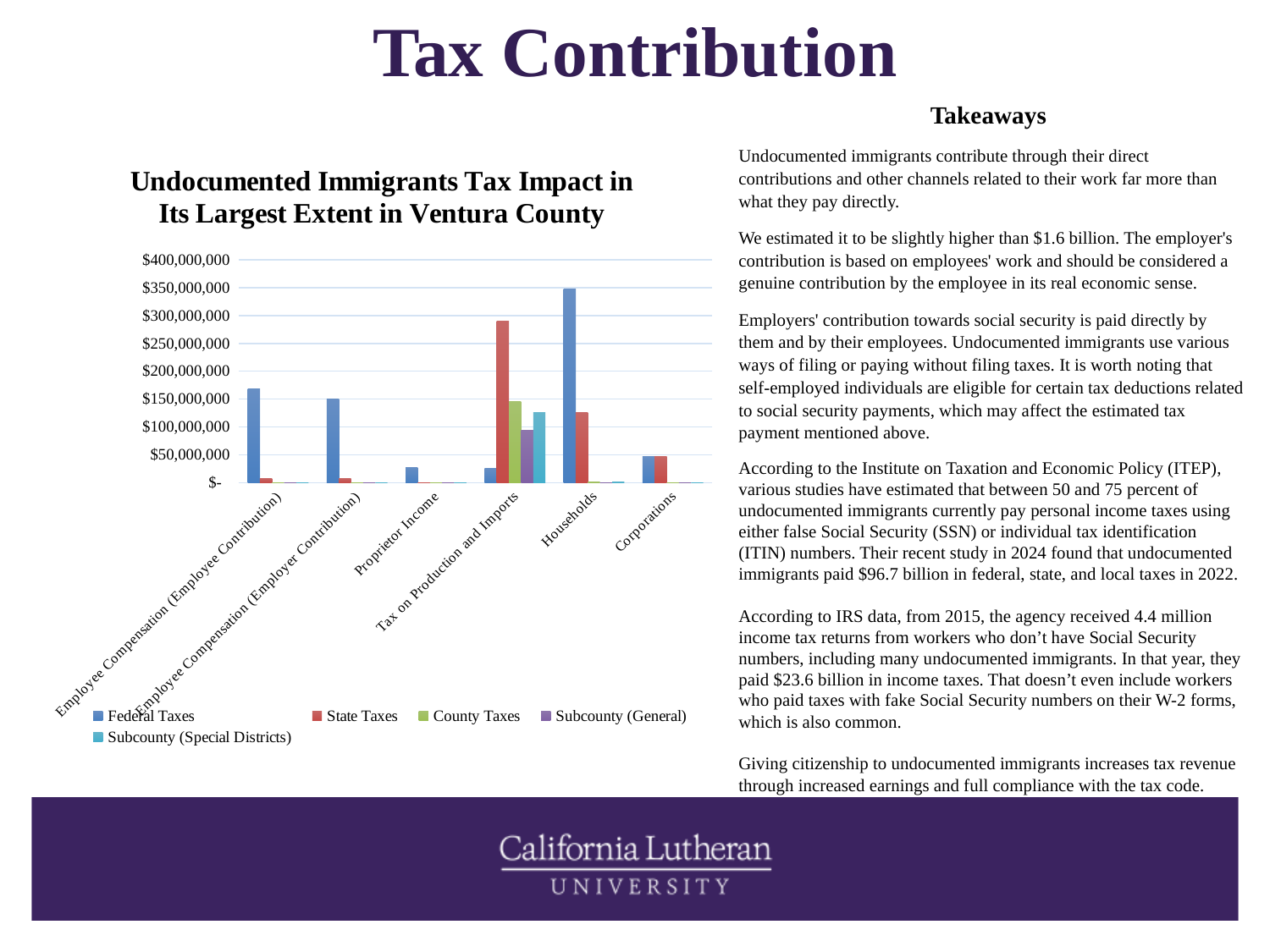
What is the title of the chart? Undocumented Immigrants Tax Impact in Its Largest Extent in Ventura County Which is larger for Households: Federal Taxes or State Taxes? Federal Taxes Is the Federal Taxes value for Employee Compensation (Employee Contribution) greater or less than $200,000,000? less How many series does the chart's legend list? 5 What kind of chart is shown on the slide? Bar chart Which is larger: the Federal Taxes value for Employee Compensation (Employee Contribution) or the Federal Taxes value for Employee Compensation (Employer Contribution)? Employee Compensation (Employee Contribution) Which category has the highest Federal Taxes value? Households Is the Federal Taxes value for Households greater or less than $300,000,000? greater Which category has the highest State Taxes value? Tax on Production and Imports Is the County Taxes value for Tax on Production and Imports greater or less than $100,000,000? greater How many categories are shown along the x axis of the chart? 6